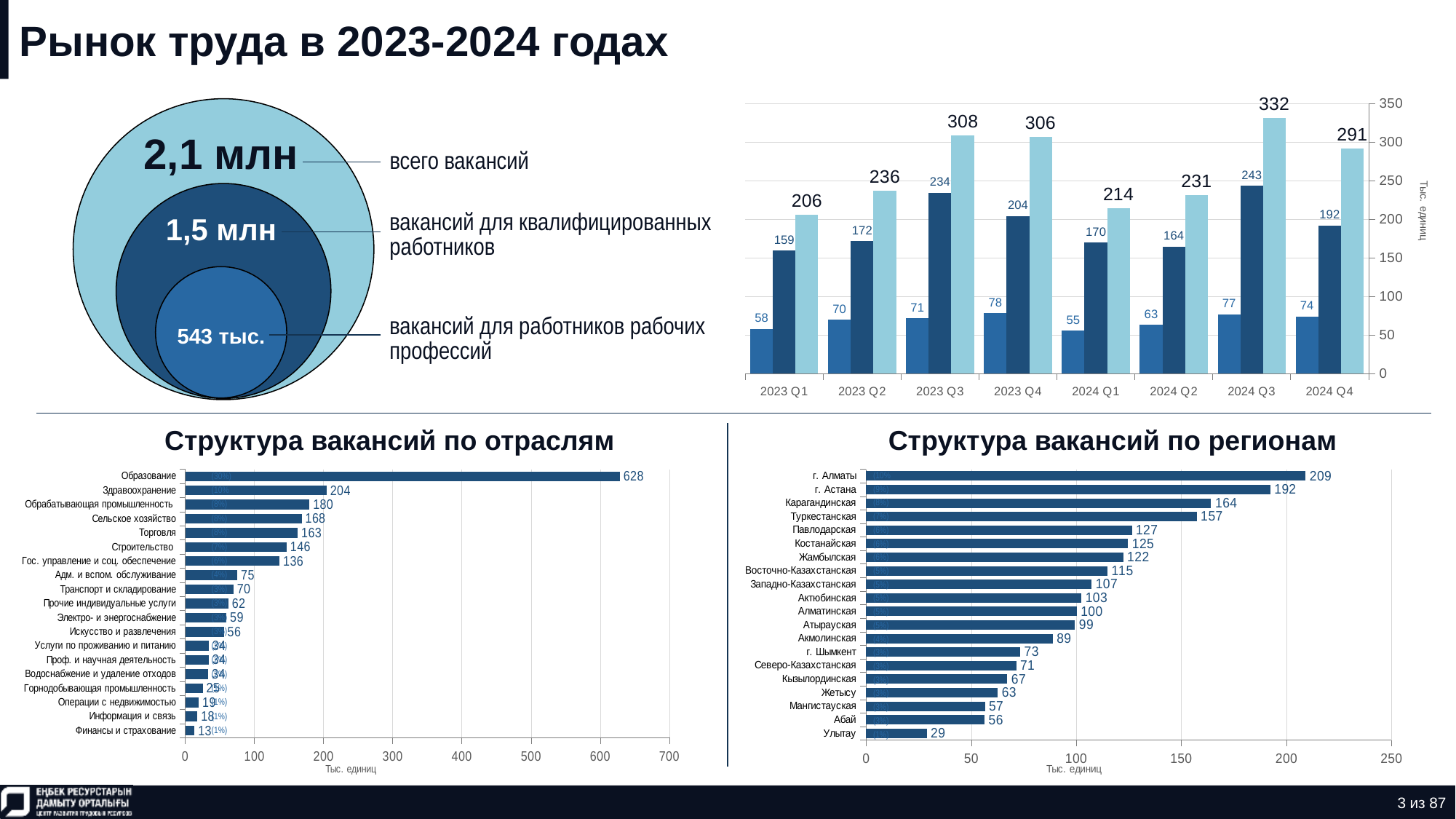
On the quarterly bar chart at the top right, what is the difference between the light blue values for 2024 Q3 and 2024 Q4? 41 In the chart 'Структура вакансий по отраслям', which industry has the highest value? Образование In the chart 'Структура вакансий по регионам', which has the larger value, Карагандинская or Туркестанская? Карагандинская In the chart 'Структура вакансий по отраслям', what is the difference between the values for Образование and Здравоохранение? 424 In the chart 'Структура вакансий по регионам', what is the value for Павлодарская? 127 In the chart 'Структура вакансий по отраслям', what is the value for Торговля? 163 In the chart 'Структура вакансий по регионам', which region has the highest value? г. Алматы On the quarterly bar chart at the top right, in which quarter does the light blue series reach its highest value? 2024 Q3 On the quarterly bar chart at the top right, what is the value of the dark navy bar for 2023 Q3? 234 On the quarterly bar chart at the top right, how many quarters are shown on the x axis? 8 What kind of chart is the quarterly chart at the top right of the slide? Bar chart In the chart 'Структура вакансий по отраслям', which industry has the lowest value? Финансы и страхование